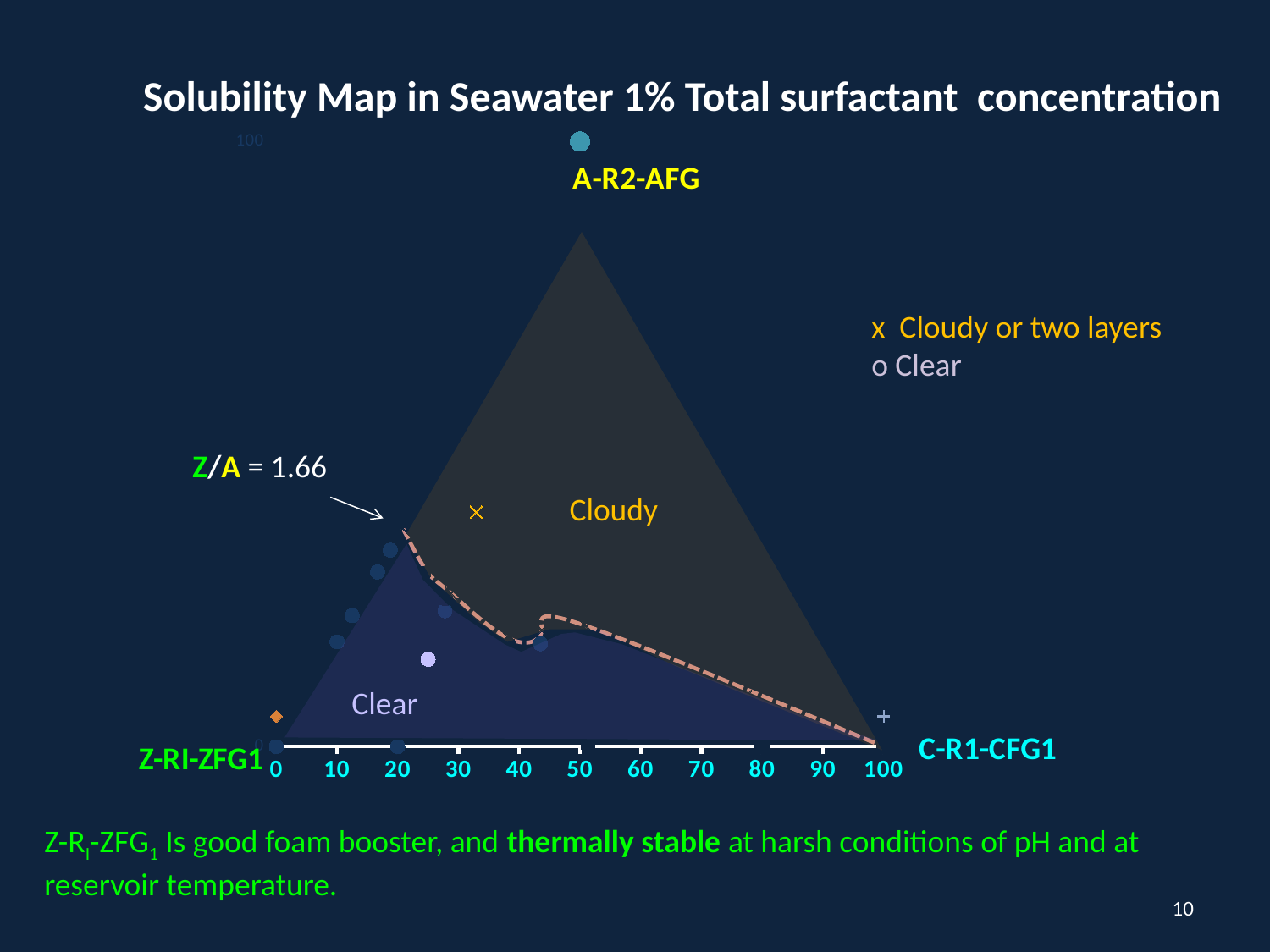
What kind of chart is shown on the slide? Ternary (triangular) diagram Which component is labelled at the top vertex of the triangle? A-R2-AFG What Z/A ratio is annotated on the chart? 1.66 Which symbol in the legend marks 'Cloudy or two layers'? x What is the maximum value shown on the bottom axis? 100 What is the spacing between consecutive tick labels on the bottom axis? 10 What is the title of the chart? Solubility Map in Seawater 1% Total surfactant concentration Which component is labelled at the bottom-right vertex of the triangle? C-R1-CFG1 How many entries does the legend list? 2 Which of the two labelled regions, Cloudy or Clear, covers the larger area of the triangle? Cloudy How many tick labels are printed along the bottom axis? 11 Which component is labelled at the bottom-left vertex of the triangle? Z-RI-ZFG1